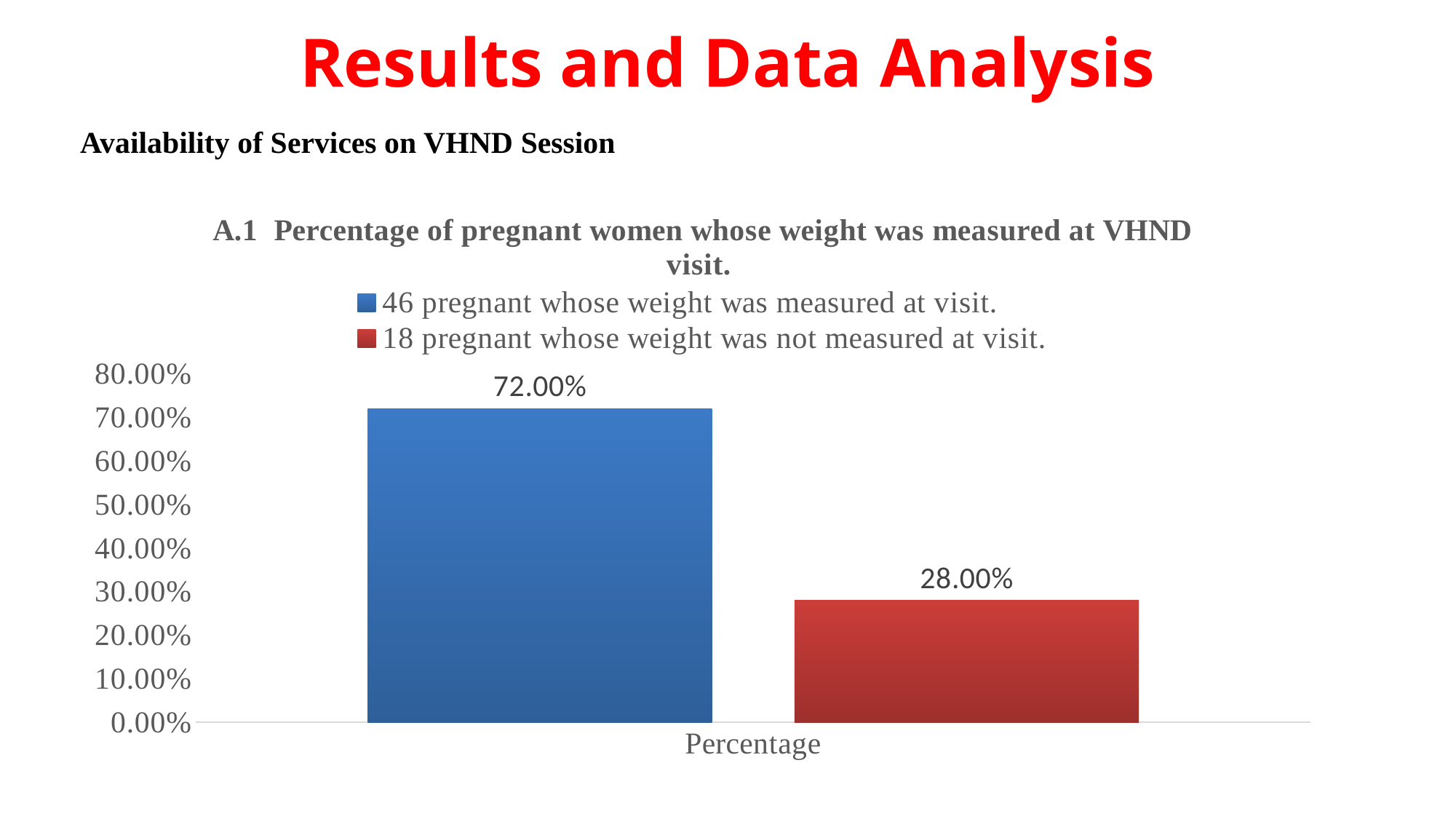
Is the value for women whose weight was not measured greater or less than 30.00%? less Which series has the higher value? 46 pregnant whose weight was measured at visit. What is the value for the series "18 pregnant whose weight was not measured at visit."? 28.00% Is the value for women whose weight was measured greater or less than 70.00%? greater How many series does the legend list? 2 What colour is the bar for women whose weight was not measured at visit? red Is the value for women whose weight was measured larger or smaller than the value for women whose weight was not measured? larger What kind of chart is shown on the slide? bar chart Which series has the lower value? 18 pregnant whose weight was not measured at visit. What is the difference between the value for women whose weight was measured and the value for women whose weight was not measured? 44.00% What is the title of the chart? A.1 Percentage of pregnant women whose weight was measured at VHND visit. What is the value for the series "46 pregnant whose weight was measured at visit."? 72.00%